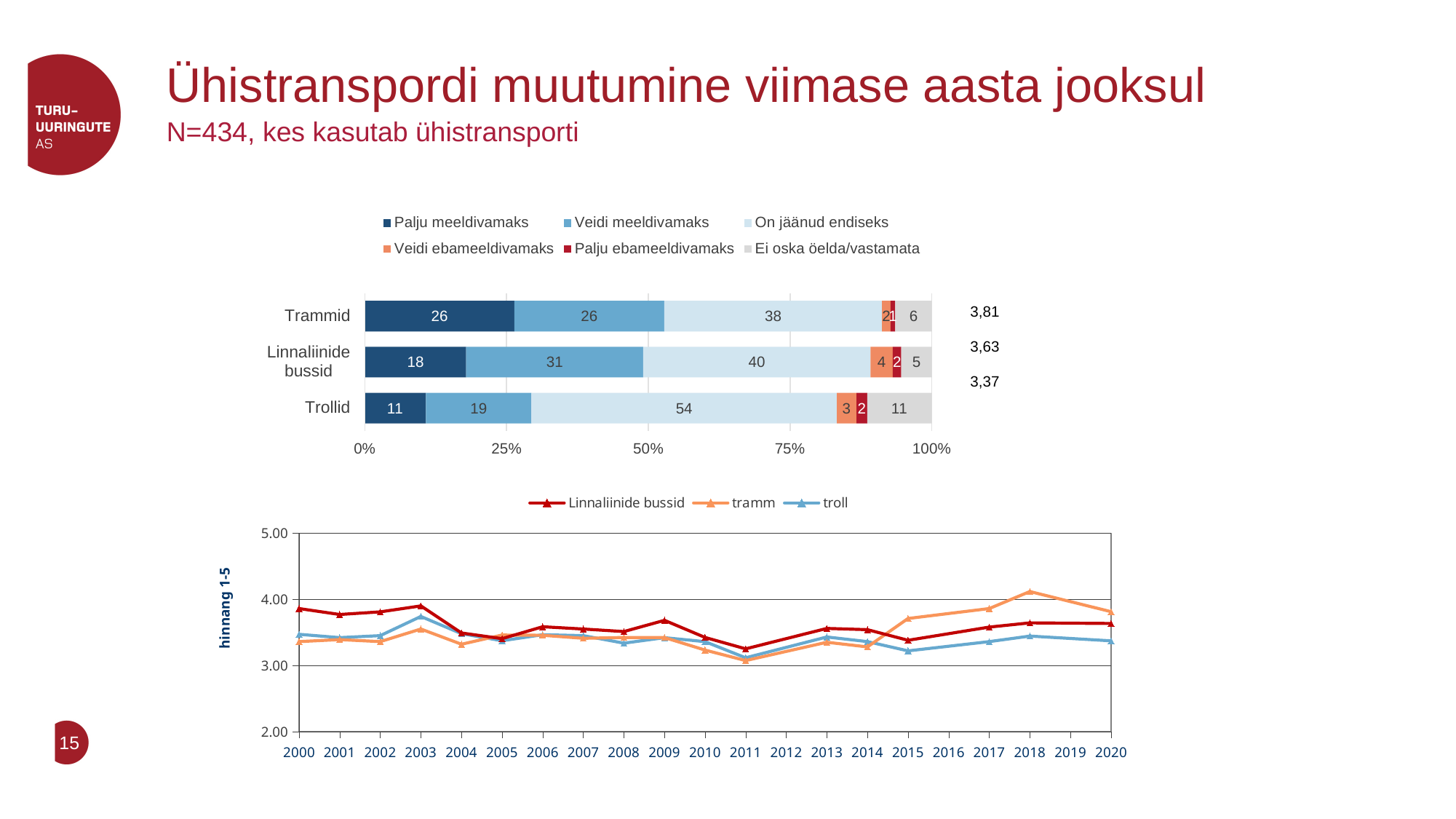
In the bottom line chart, is the value for tramm in 2018 greater or less than 4.00? greater In the top stacked bar chart, which is larger: the 'Veidi meeldivamaks' value for Trammid or for Trollid? Trammid In the top stacked bar chart, what percentage of respondents said trams (Trammid) became much more pleasant (Palju meeldivamaks)? 26 In the top stacked bar chart, which category has the lowest 'Palju meeldivamaks' value? Trollid In the top stacked bar chart, what is the 'Veidi meeldivamaks' value for Linnaliinide bussid? 31 In the bottom line chart, how many years are shown on the x axis? 21 How many series does the legend of the top stacked bar chart list? 6 In the top stacked bar chart, which category has the highest 'Ei oska öelda/vastamata' value? Trollid In the top stacked bar chart, what is the 'On jäänud endiseks' value for Trollid? 54 In the top stacked bar chart, what mean score is shown to the right of the Linnaliinide bussid bar? 3,63 What type of chart is the bottom chart on the slide? Line chart In the top stacked bar chart, what is the difference between the 'On jäänud endiseks' values for Trollid and Trammid? 16